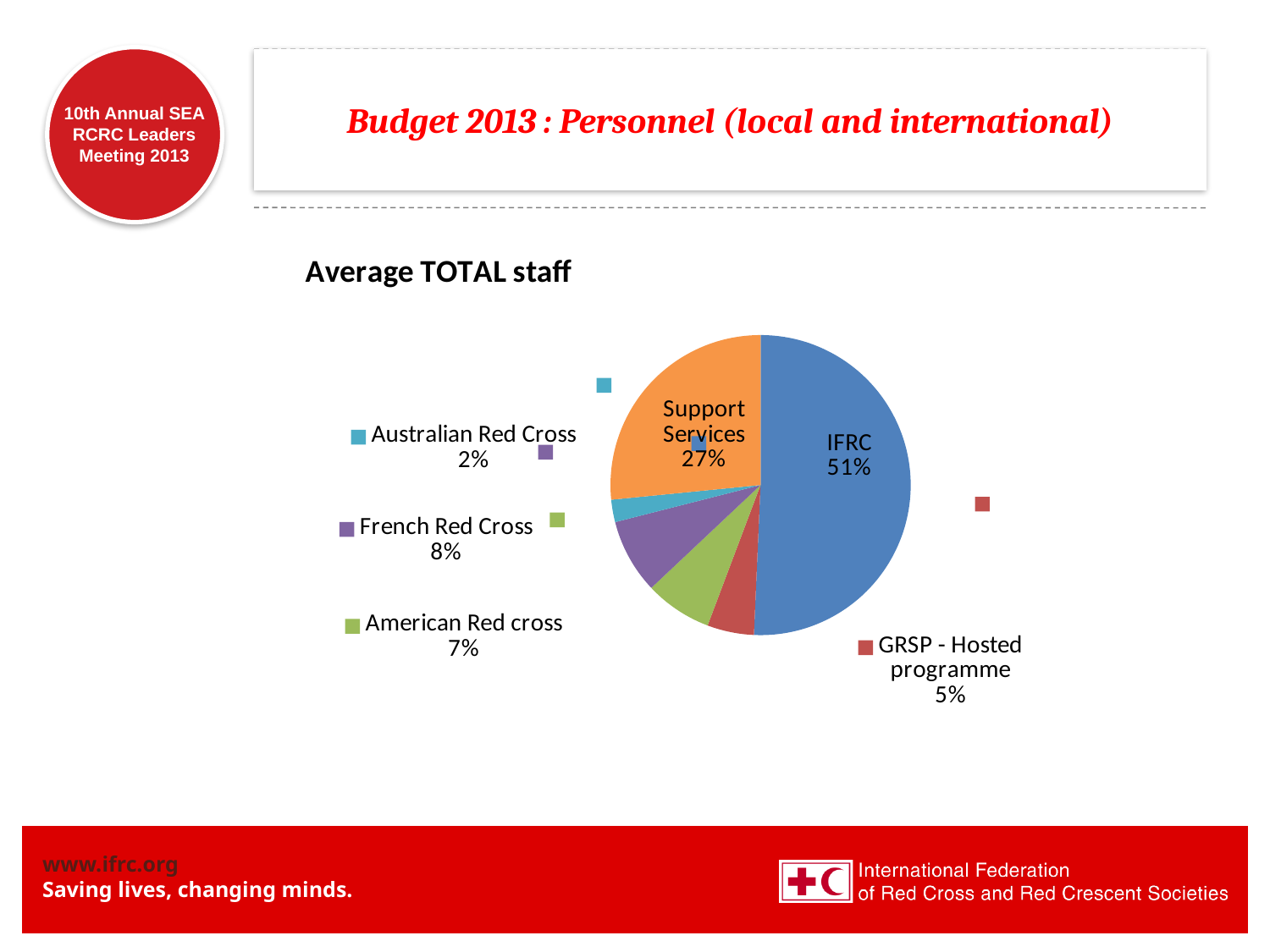
What is the value for American Red cross? 7% What is the value for French Red Cross? 8% Which category has the largest slice of the pie? IFRC What is the difference in percentage points between IFRC and Support Services? 24 percentage points What share of the pie does Support Services account for? 27% What share of the pie does IFRC account for? 51% What kind of chart is shown on the slide? pie chart How many slices does the pie chart have? 6 What is the title of the chart? Average TOTAL staff What is the value for GRSP - Hosted programme? 5% Which category has the smallest slice of the pie? Australian Red Cross What is the value for Australian Red Cross? 2%